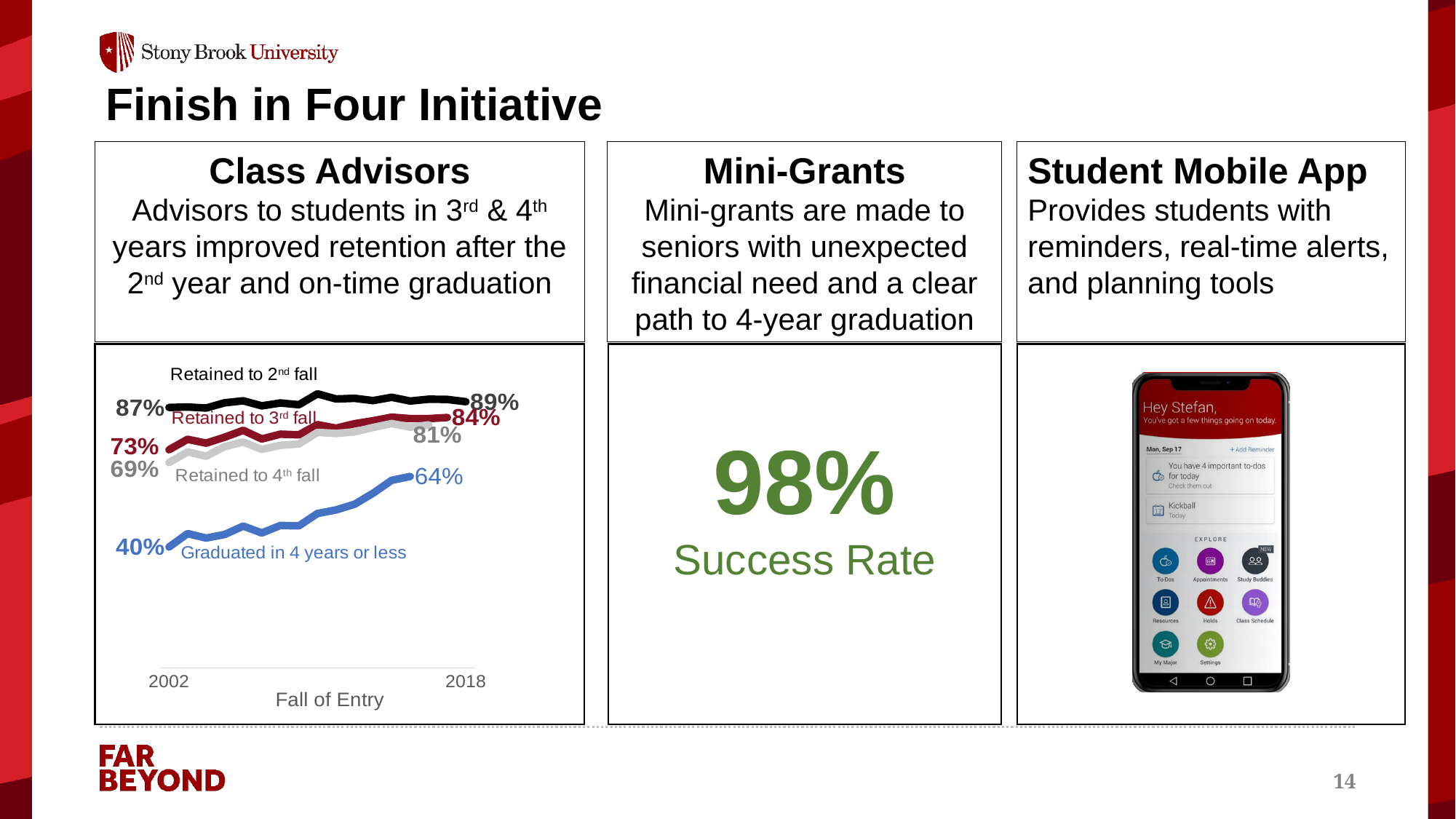
In the Class Advisors chart, what was the value for 'Retained to 2nd fall' in 2018? 89% How many data series are plotted in the Class Advisors chart? 4 In the Class Advisors chart, does the 'Graduated in 4 years or less' line rise or fall from 2002 to 2018? rise In the Class Advisors chart, what was the value for 'Retained to 2nd fall' in 2002? 87% What kind of chart is shown in the Class Advisors panel? line chart In the Class Advisors chart, which series had the lowest value in 2002? Graduated in 4 years or less In the Class Advisors chart, what was the value for 'Retained to 4th fall' in 2002? 69% In the Class Advisors chart, which series had the highest value in 2018? Retained to 2nd fall